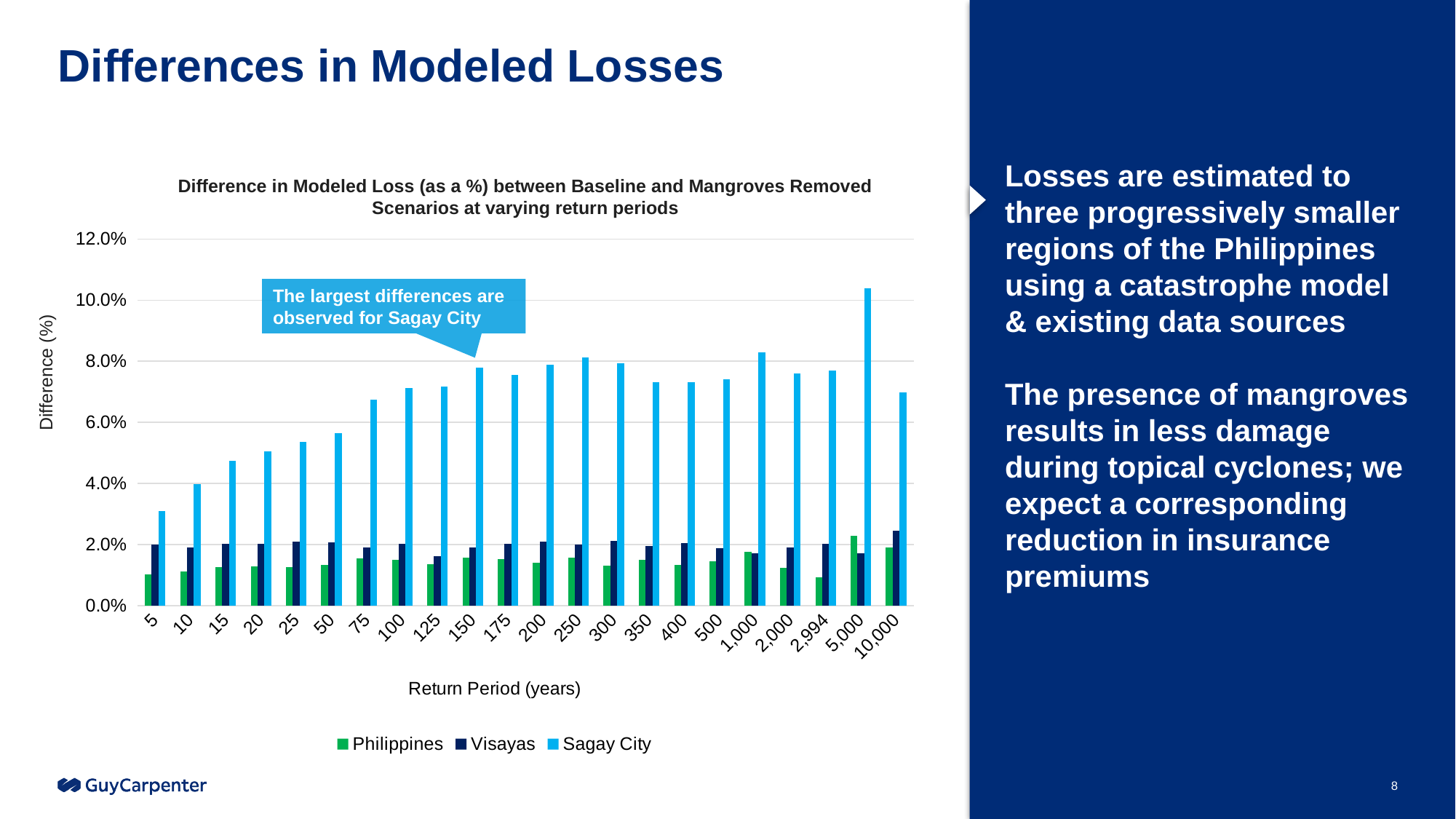
Is the Sagay City value at the 5-year return period greater or less than 4.0%? less Is the Sagay City value at the 5,000-year return period greater or less than 10.0%? greater What kind of chart is shown on the slide? bar chart For which return period is the Sagay City value lowest? 5 How many series does the legend list? 3 At the 5,000-year return period, which is larger: the Philippines value or the Visayas value? Philippines Do the Sagay City values rise or fall from the 5-year to the 250-year return period? rise For which return period is the Sagay City value highest? 5,000 Is the Sagay City value at the 100-year return period greater or less than 6.0%? greater According to the callout on the chart, for which region are the largest differences observed? Sagay City At the 2,994-year return period, which is larger: the Philippines value or the Visayas value? Visayas How many return periods are shown on the x axis? 22